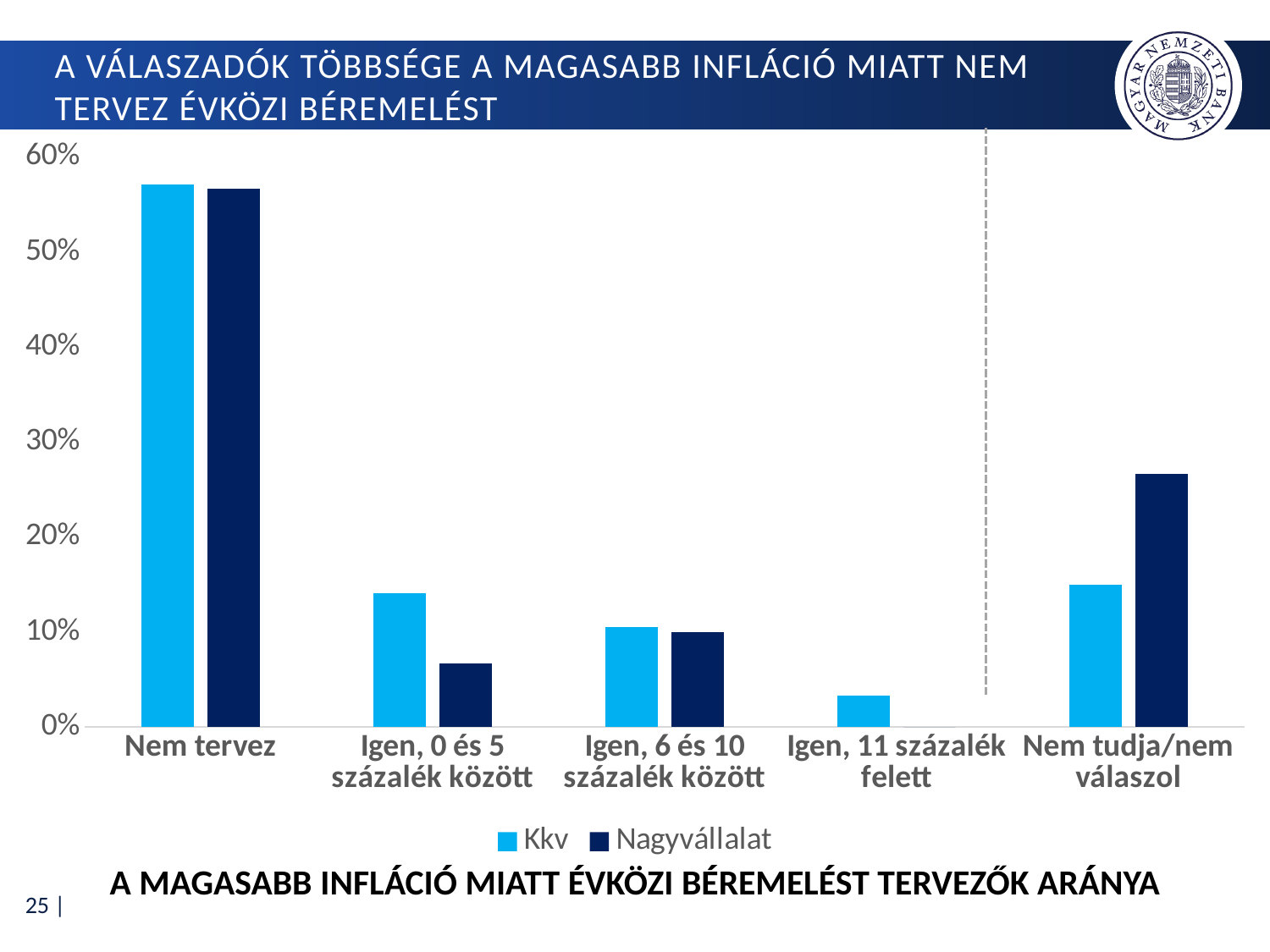
Is the Kkv value for Nem tervez greater or less than 50%? greater Is the Kkv value for Igen, 0 és 5 százalék között greater or less than 10%? greater For the category Nem tudja/nem válaszol, which series has the larger value, Kkv or Nagyvállalat? Nagyvállalat Which category has the highest value for the Kkv series? Nem tervez For the category Igen, 0 és 5 százalék között, which series has the larger value, Kkv or Nagyvállalat? Kkv How many categories are shown on the x axis of the chart? 5 Which category has the lowest value for the Kkv series? Igen, 11 százalék felett What kind of chart is shown on the slide? bar chart What are the two series named in the chart's legend? Kkv and Nagyvállalat Is the Nagyvállalat value for Nem tudja/nem válaszol greater or less than 20%? greater Which category has the highest value for the Nagyvállalat series? Nem tervez How many series does the chart's legend list? 2